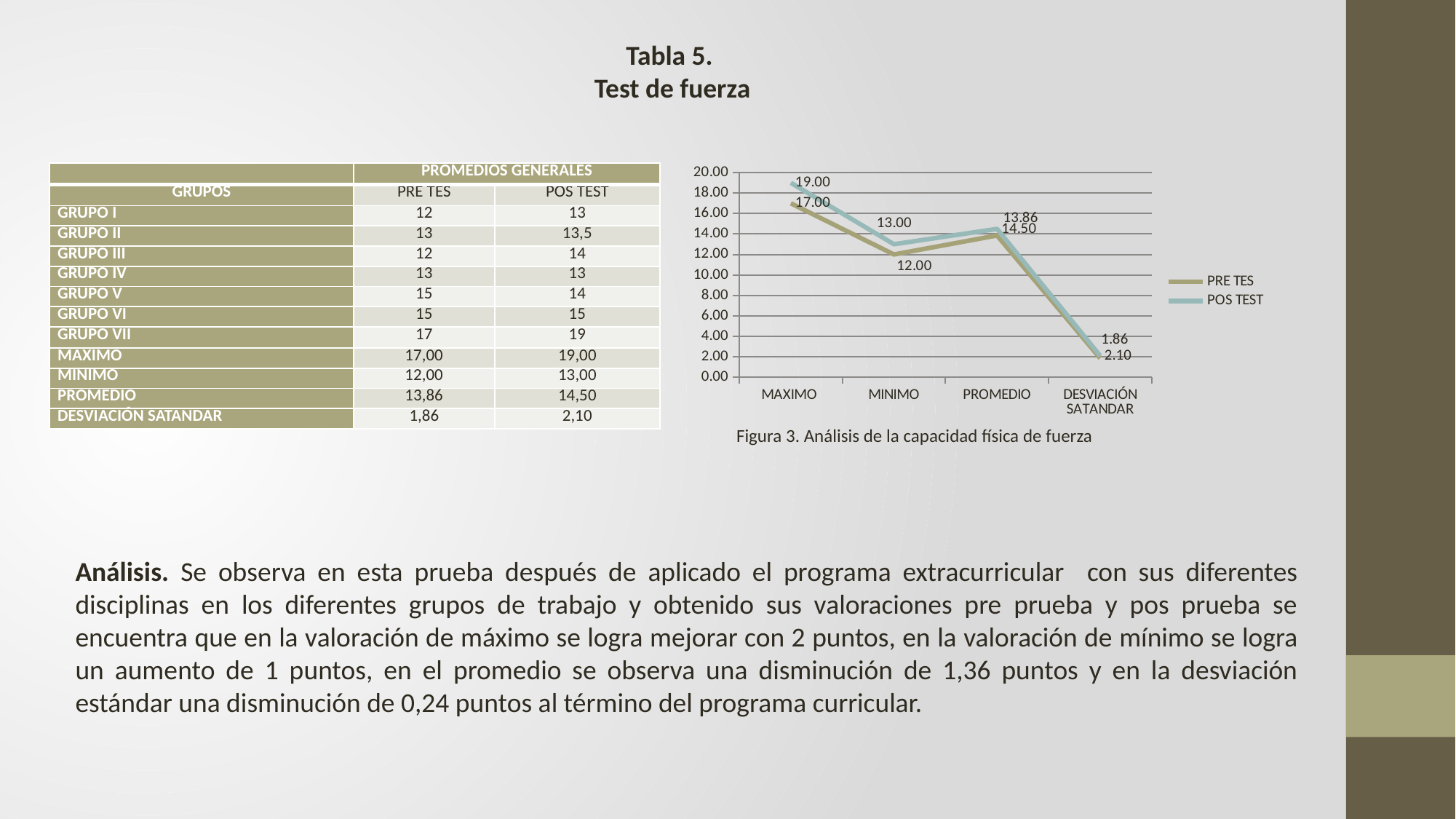
For MAXIMO, which series has the larger value in the chart, PRE TES or POS TEST? POS TEST What is the POS TEST value for MAXIMO in the chart? 19.00 Which category has the highest PRE TES value in the chart? MAXIMO What are the names of the two series in the chart legend? PRE TES and POS TEST How many categories are shown on the x axis of the chart? 4 What is the POS TEST value for PROMEDIO in the chart? 14.50 Which category has the lowest POS TEST value in the chart? DESVIACIÓN SATANDAR How many series does the chart legend list? 2 What is the PRE TES value for DESVIACIÓN SATANDAR in the chart? 1.86 What type of chart is shown in Figura 3? line chart What is the difference between the POS TEST and PRE TES values for MINIMO in the chart? 1.00 What is the PRE TES value for MAXIMO in the chart? 17.00